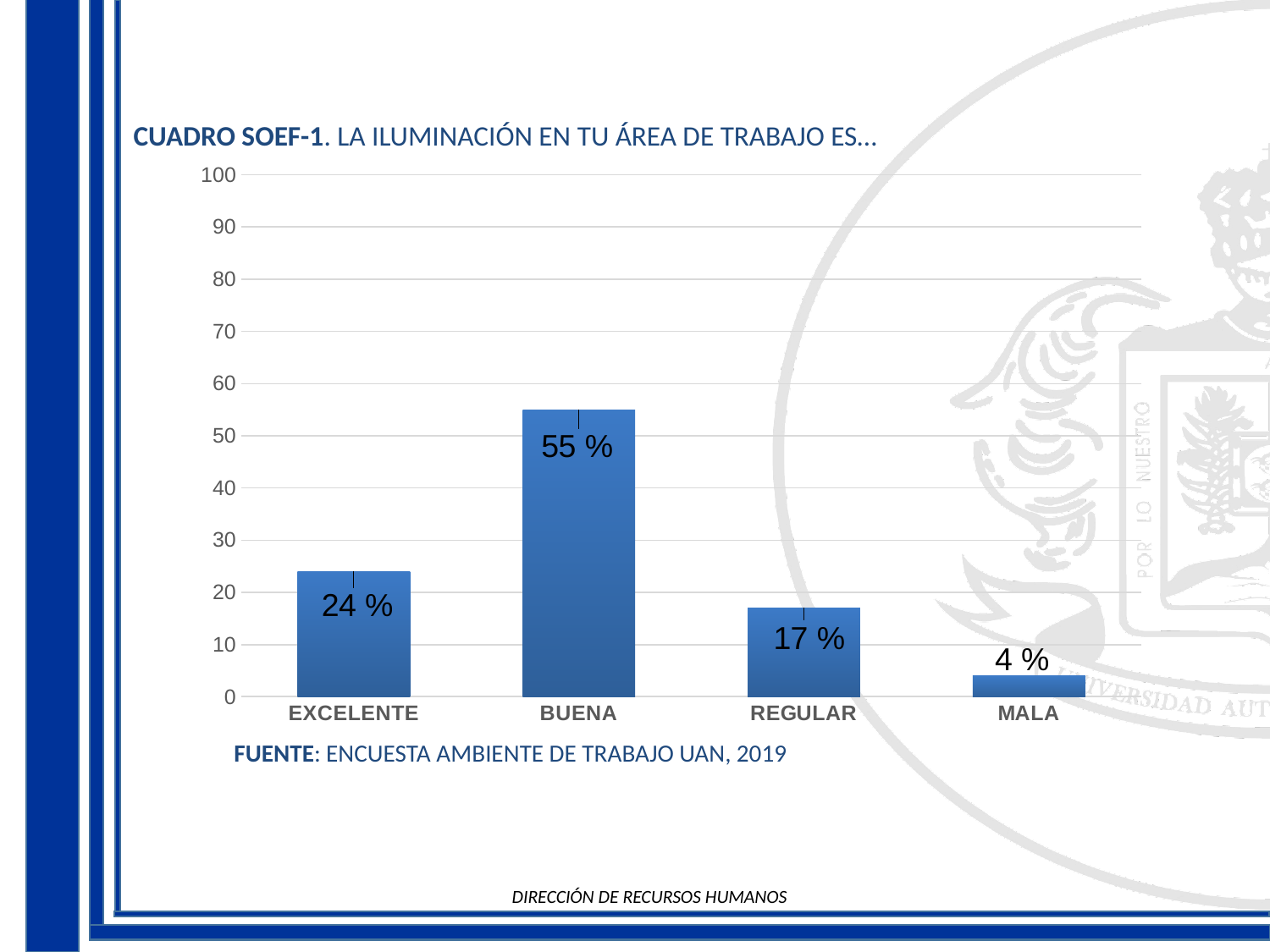
What is the difference between the values for BUENA and EXCELENTE? 31 % What is the difference between the values for REGULAR and MALA? 13 % What is the value for MALA? 4 % What is the value for REGULAR? 17 % Which is larger, the value for EXCELENTE or the value for REGULAR? EXCELENTE How many categories are shown on the x axis? 4 What is the value for BUENA? 55 % What is the value for EXCELENTE? 24 % What source is cited below the chart? ENCUESTA AMBIENTE DE TRABAJO UAN, 2019 Which category has the lowest value? MALA Which category has the highest value? BUENA What kind of chart is shown on the slide? Bar chart